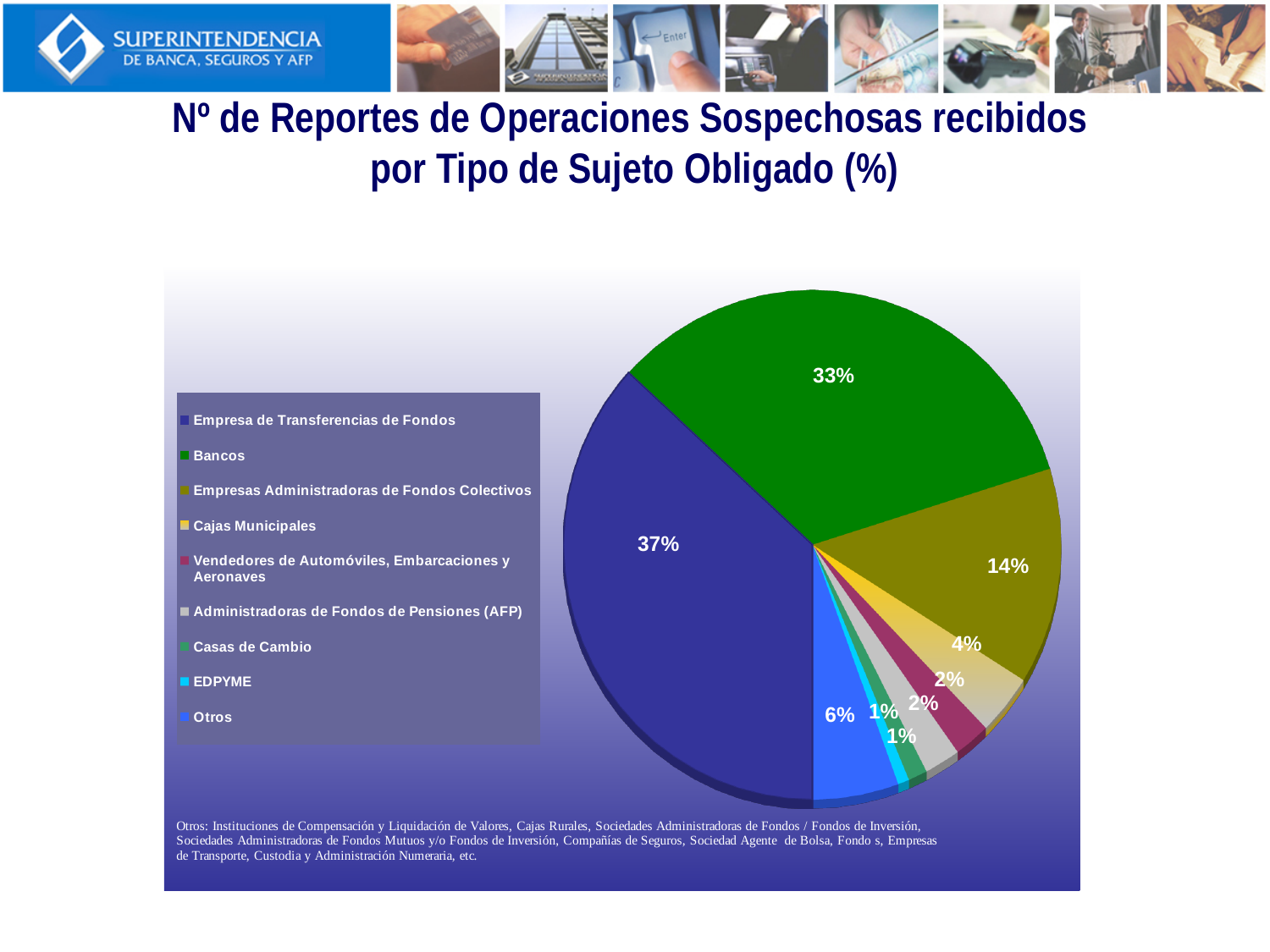
Which colour represents Bancos in the pie chart? Green What is the title of the chart? Nº de Reportes de Operaciones Sospechosas recibidos por Tipo de Sujeto Obligado (%) What is the difference in percentage points between Empresa de Transferencias de Fondos and Bancos? 4 percentage points What kind of chart is shown on the slide? Pie chart Which is larger, the share for Bancos or the share for Empresas Administradoras de Fondos Colectivos? Bancos What is the combined share of Empresa de Transferencias de Fondos and Bancos? 70% What share of the pie corresponds to Otros? 6% How many categories does the legend list? 9 Which category has the largest share of the pie? Empresa de Transferencias de Fondos What share of the pie corresponds to Cajas Municipales? 4% What share of the pie corresponds to Empresas Administradoras de Fondos Colectivos? 14% What share of the pie corresponds to Bancos? 33%